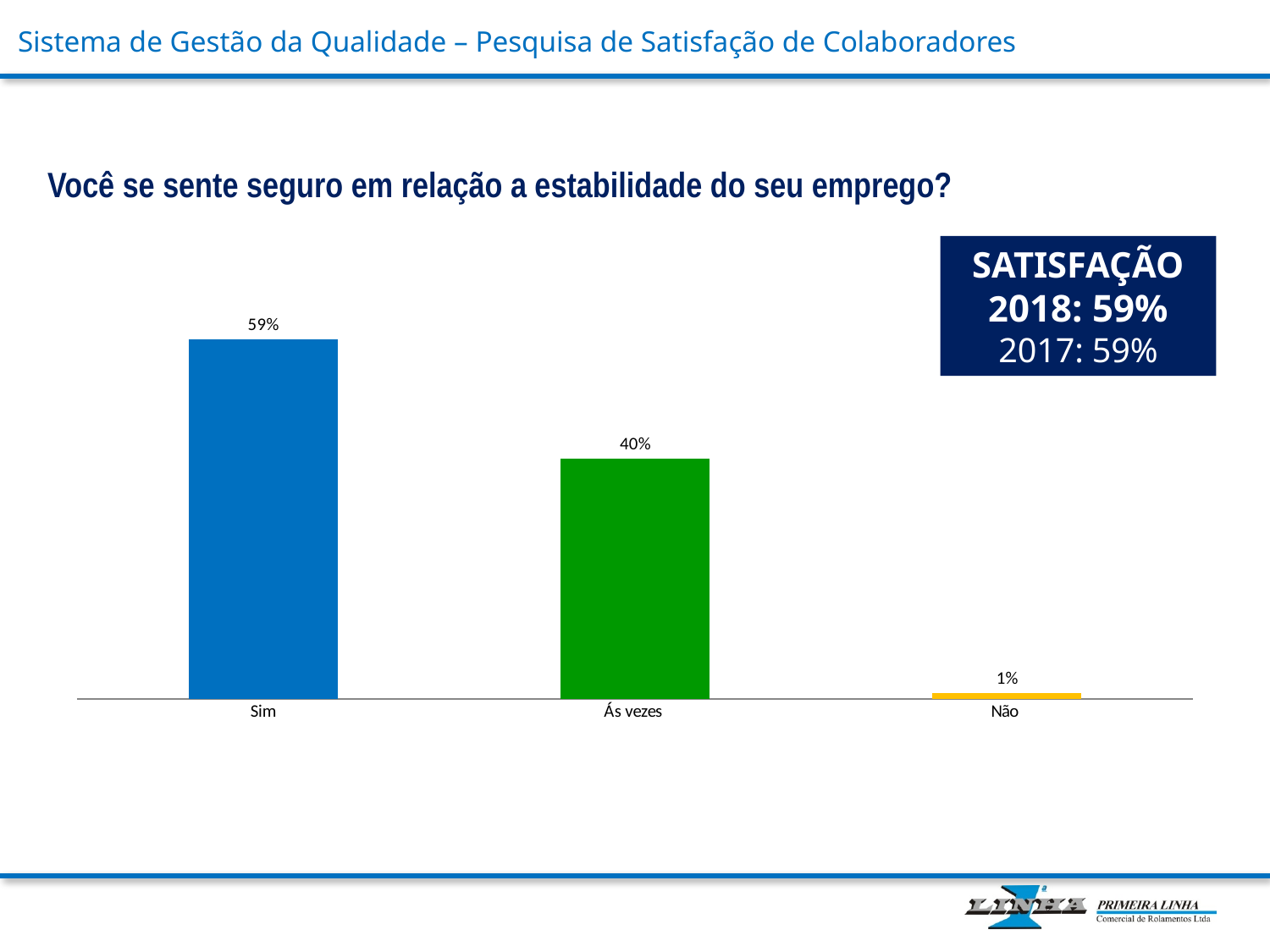
What is the difference between the values for "Sim" and "Ás vezes"? 19% What is the difference between the values for "Ás vezes" and "Não"? 39% What kind of chart is shown on the slide? Bar chart Which is larger, the value for "Sim" or the value for "Ás vezes"? Sim What is the value for "Não"? 1% Which category has the lowest value? Não What is the value for "Ás vezes"? 40% Which category has the highest value? Sim Do the values rise or fall from left to right across the categories? Fall How many categories are shown in the chart? 3 What is the value for "Sim"? 59% What colour is the bar for "Ás vezes"? Green